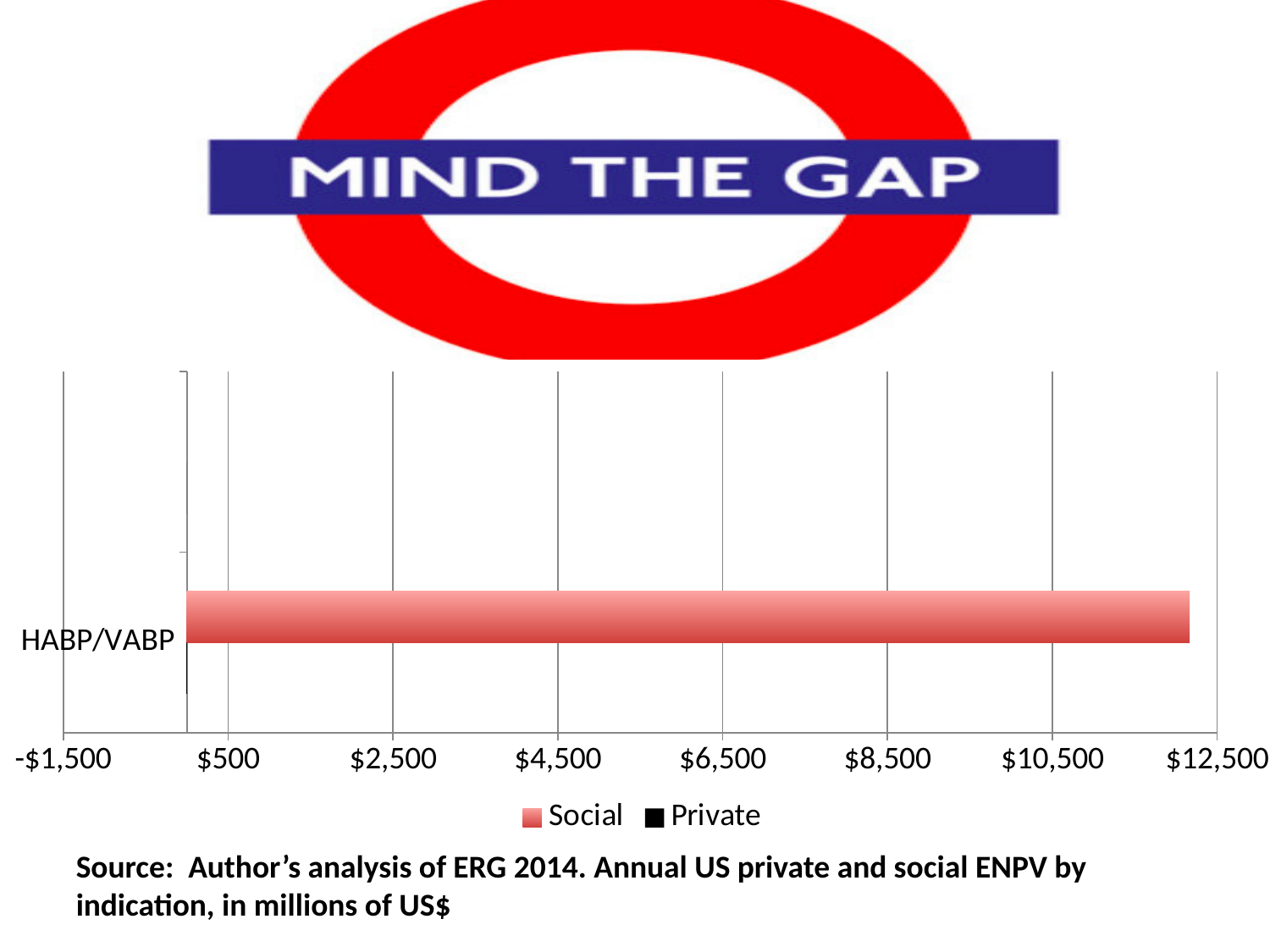
Is the Social value for HABP/VABP greater or less than $10,500? greater Is the Social value for HABP/VABP greater or less than $12,500? less What is the name of the category plotted on the chart? HABP/VABP What is the highest value labelled on the horizontal axis? $12,500 Which series has the smaller value for HABP/VABP? Private Which series has the larger value for HABP/VABP, Social or Private? Social How many categories are plotted on the chart? 1 How many series does the chart legend list? 2 Is the Private value for HABP/VABP greater or less than $500? less What are the two series named in the chart legend? Social and Private What kind of chart is shown on the slide? bar chart